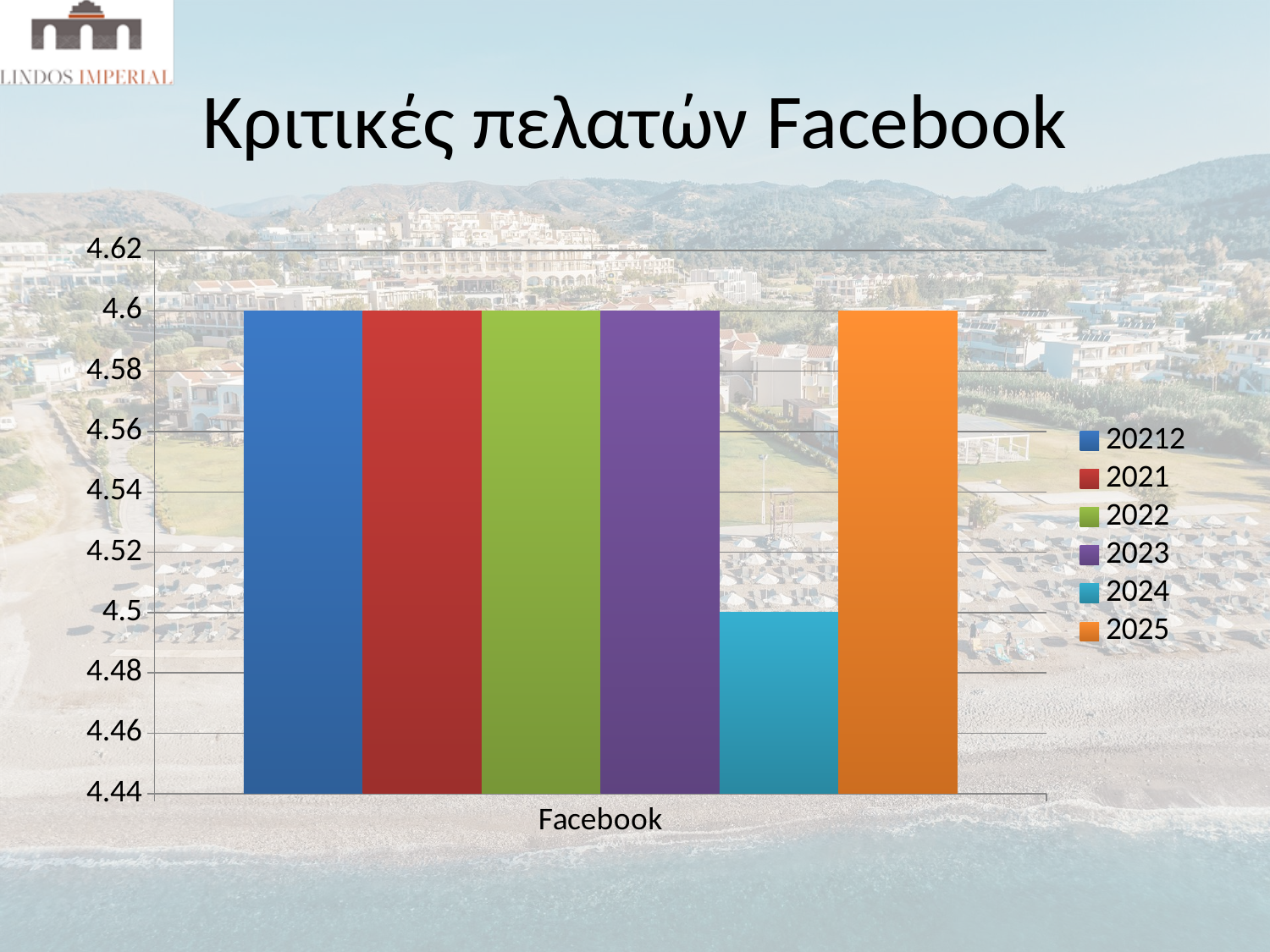
What is the difference between the value for 2025 and the value for 2024? 0.1 How many series does the legend list? 6 What is the title of the slide? Κριτικές πελατών Facebook What is the value for the 2024 series? 4.5 Which is larger, the value for 2023 or the value for 2024? 2023 What type of chart is shown on the slide? bar chart What is the value for the 2021 series? 4.6 What is the value for the 2025 series? 4.6 Is the value for 2024 greater or less than 4.52? less What is the category label shown on the x axis? Facebook Is the value for 2022 greater or less than 4.58? greater Which series has the lowest value? 2024